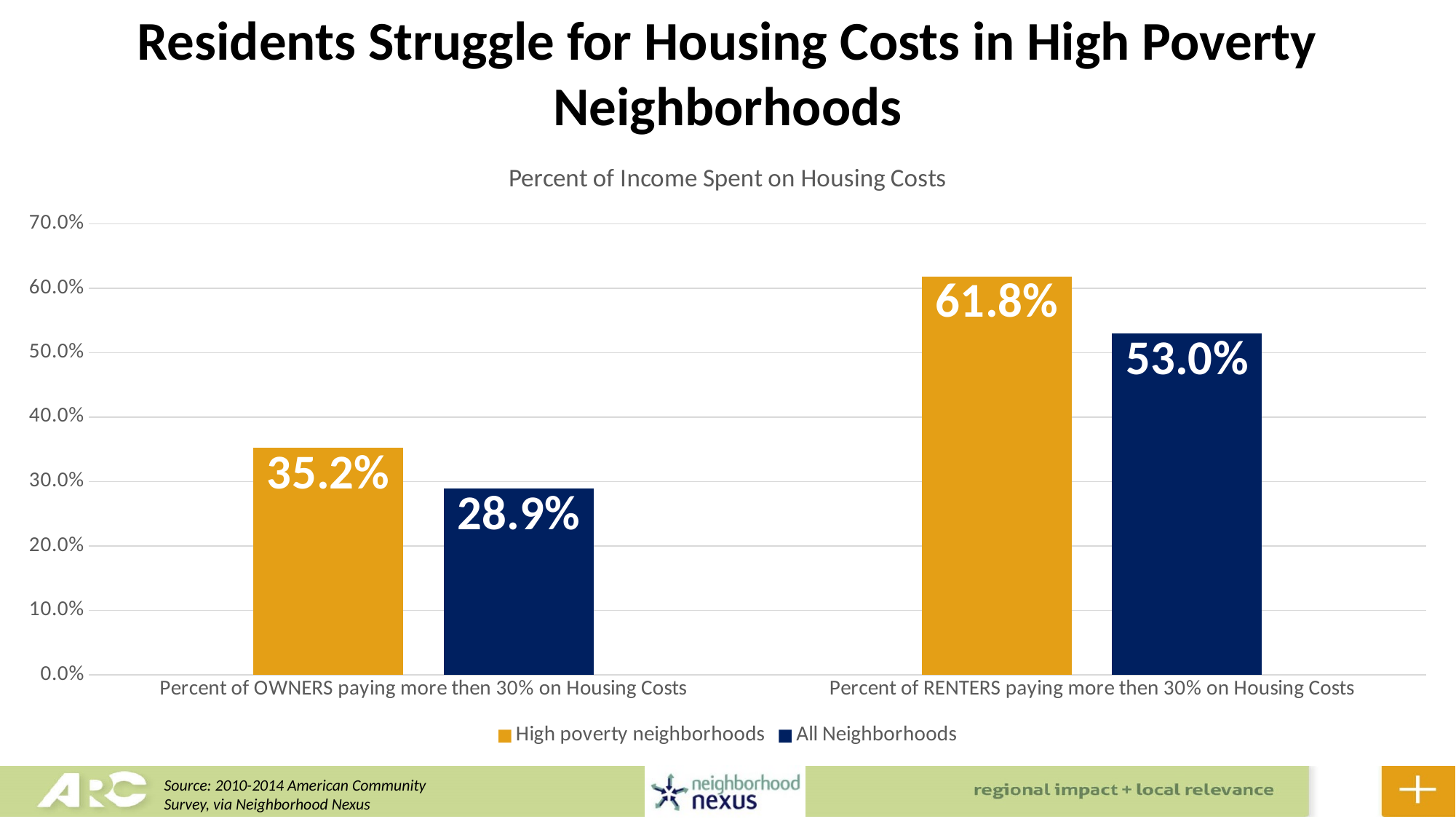
What is the difference between high poverty neighborhoods and all neighborhoods for owners? 6.3 percentage points What percent of renters in all neighborhoods pay more than 30% on housing costs? 53.0% What is the value for renters in high poverty neighborhoods? 61.8% What is the difference between high poverty neighborhoods and all neighborhoods for renters? 8.8 percentage points Which bar has the highest value on the chart? High poverty neighborhoods, renters (61.8%) What kind of chart is shown on the slide? Bar chart Which bar has the lowest value on the chart? All Neighborhoods, owners (28.9%) For owners, which is larger: high poverty neighborhoods or all neighborhoods? High poverty neighborhoods What percent of owners in high poverty neighborhoods pay more than 30% on housing costs? 35.2% What is the title of the chart? Percent of Income Spent on Housing Costs What is the value for owners in all neighborhoods? 28.9% How many series does the legend list? 2